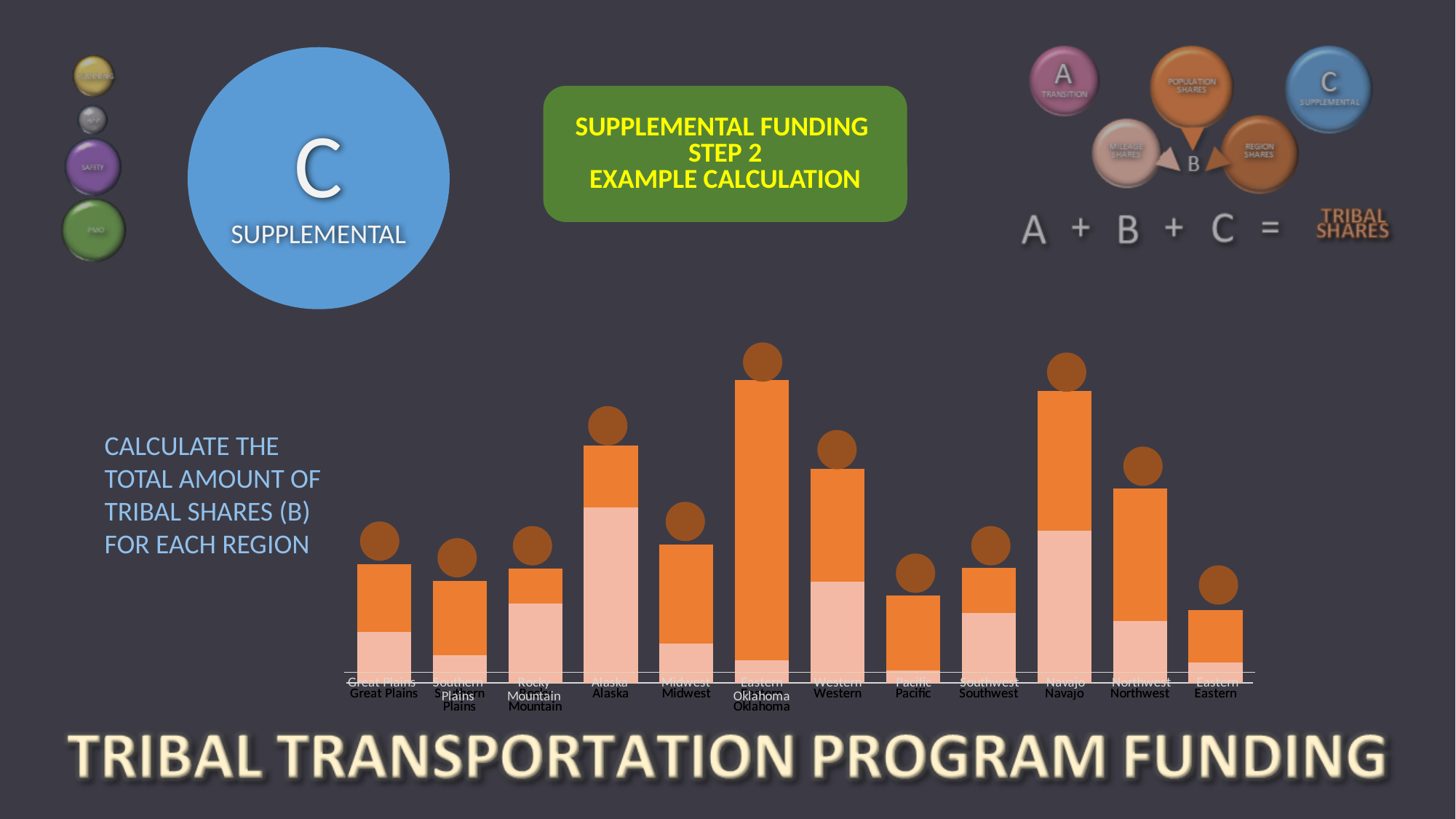
Which region has the tallest bar in the chart? Eastern Oklahoma What is the label of the first region on the left of the chart? Great Plains How many stacked segments make up each bar in the chart? 2 Which bar is taller, Alaska or Western? Alaska Which bar is taller, Navajo or Alaska? Navajo Which bar is taller, Pacific or Southwest? Southwest How many regions are shown along the x axis of the bar chart? 12 What kind of chart is shown on the slide? stacked bar chart What text appears in the green box at the top of the slide? SUPPLEMENTAL FUNDING STEP 2 EXAMPLE CALCULATION Which region has the shortest bar in the chart? Eastern